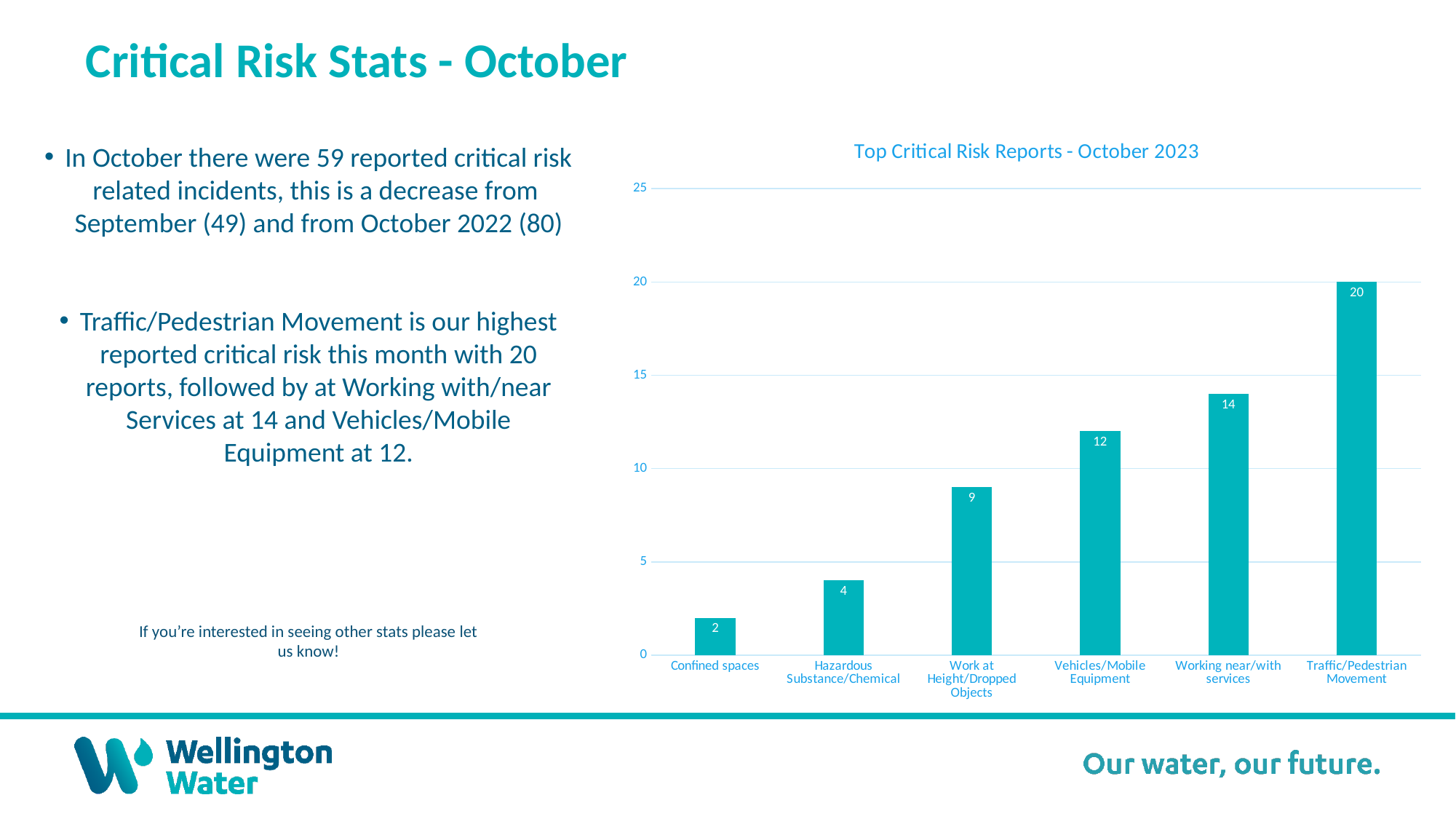
How many categories are shown on the chart? 6 What is the value for Work at Height/Dropped Objects? 9 What is the title of the chart? Top Critical Risk Reports - October 2023 Which category has the highest value? Traffic/Pedestrian Movement What is the value for Hazardous Substance/Chemical? 4 What is the value for Vehicles/Mobile Equipment? 12 What kind of chart is shown on the slide? bar chart What is the value for Confined spaces? 2 Is the value for Working near/with services greater or less than 10? greater Which is larger, Work at Height/Dropped Objects or Vehicles/Mobile Equipment? Vehicles/Mobile Equipment What is the difference between Traffic/Pedestrian Movement and Working near/with services? 6 Which category has the lowest value? Confined spaces